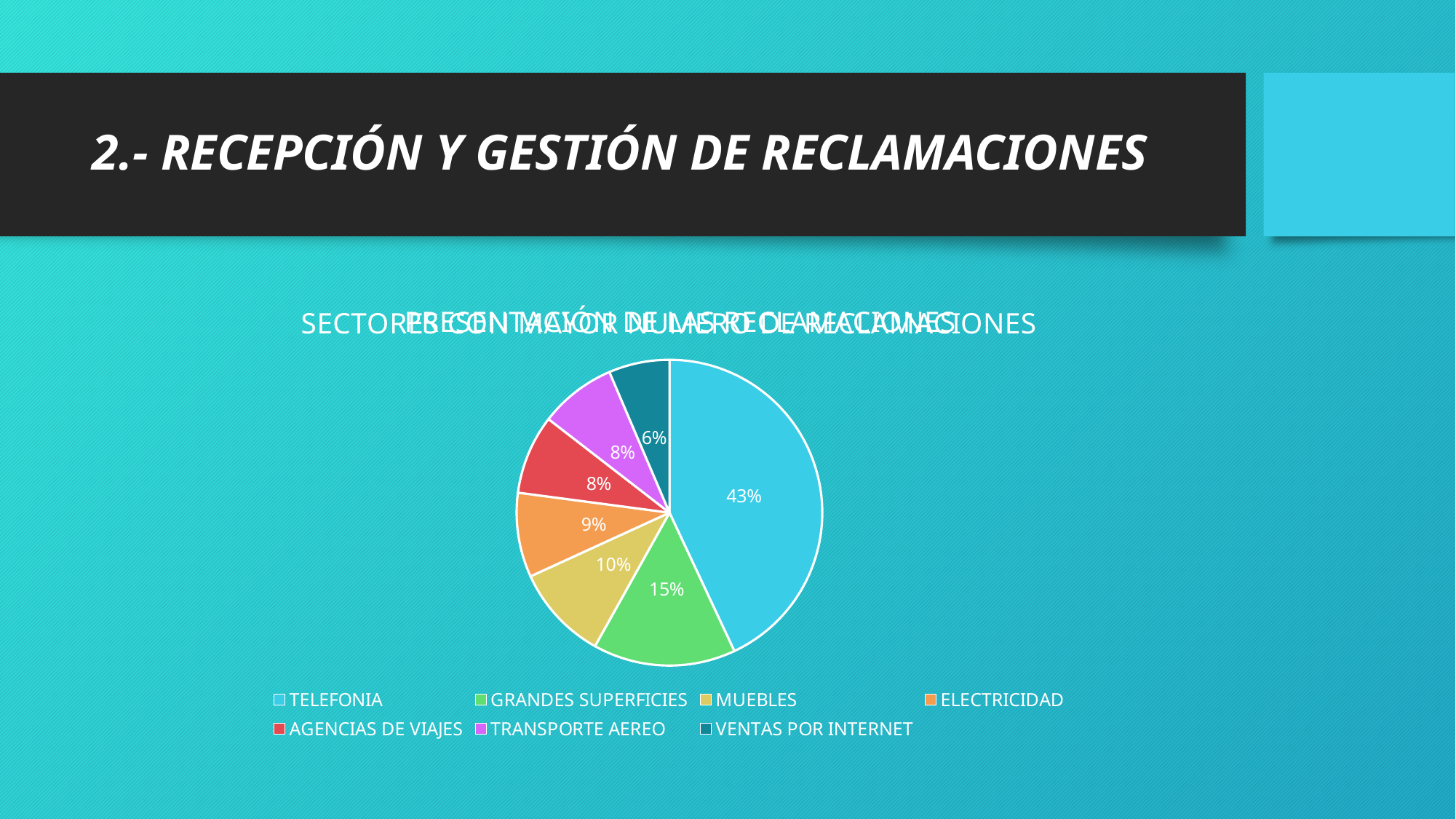
What is the combined share of AGENCIAS DE VIAJES and TRANSPORTE AEREO? 16% What type of chart is shown on the slide? Pie chart How many sectors are shown in the pie chart? 7 What colour is the slice for TRANSPORTE AEREO? Magenta Which sector has the largest slice of the pie? TELEFONIA What percentage is shown for GRANDES SUPERFICIES? 15% What percentage does VENTAS POR INTERNET account for? 6% Which is larger, the slice for ELECTRICIDAD or the slice for VENTAS POR INTERNET? ELECTRICIDAD What is the value labelled for MUEBLES? 10% Which sector has the smallest slice of the pie? VENTAS POR INTERNET What share of the pie does TELEFONIA represent? 43% What is the difference in percentage points between TELEFONIA and GRANDES SUPERFICIES? 28